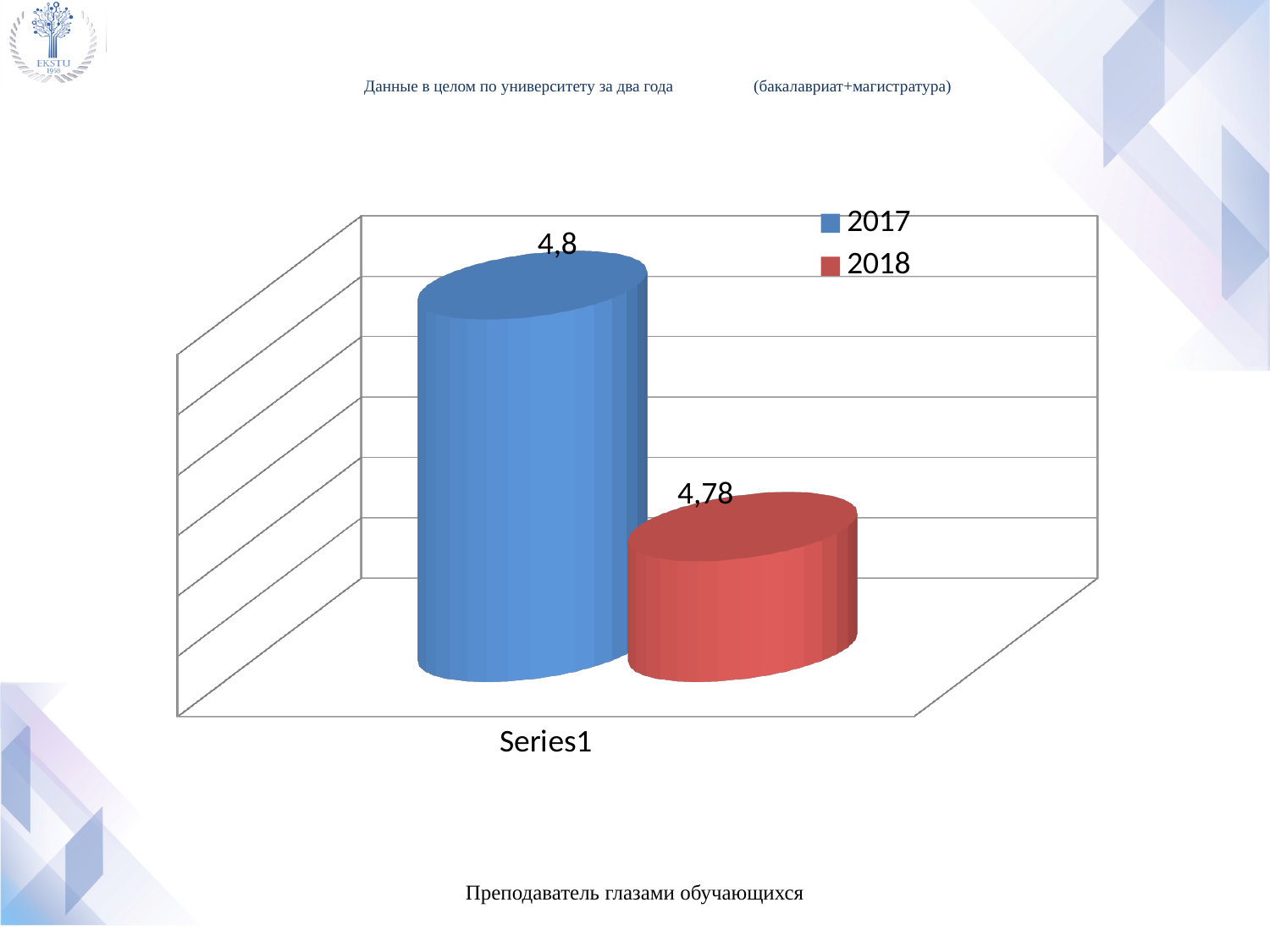
Did the value fall or rise from 2017 to 2018? fall What is the value shown for 2018? 4,78 Which year has the higher value, 2017 or 2018? 2017 How many categories are shown on the horizontal axis? 1 Which series has the highest value on the chart? 2017 Which series has the lowest value on the chart? 2018 What kind of chart is shown on the slide? bar chart What is the difference between the 2017 value and the 2018 value? 0,02 How many series does the legend list? 2 What is the label of the category on the horizontal axis? Series1 What is the value shown for 2017? 4,8 What colour represents 2018 in the chart? red